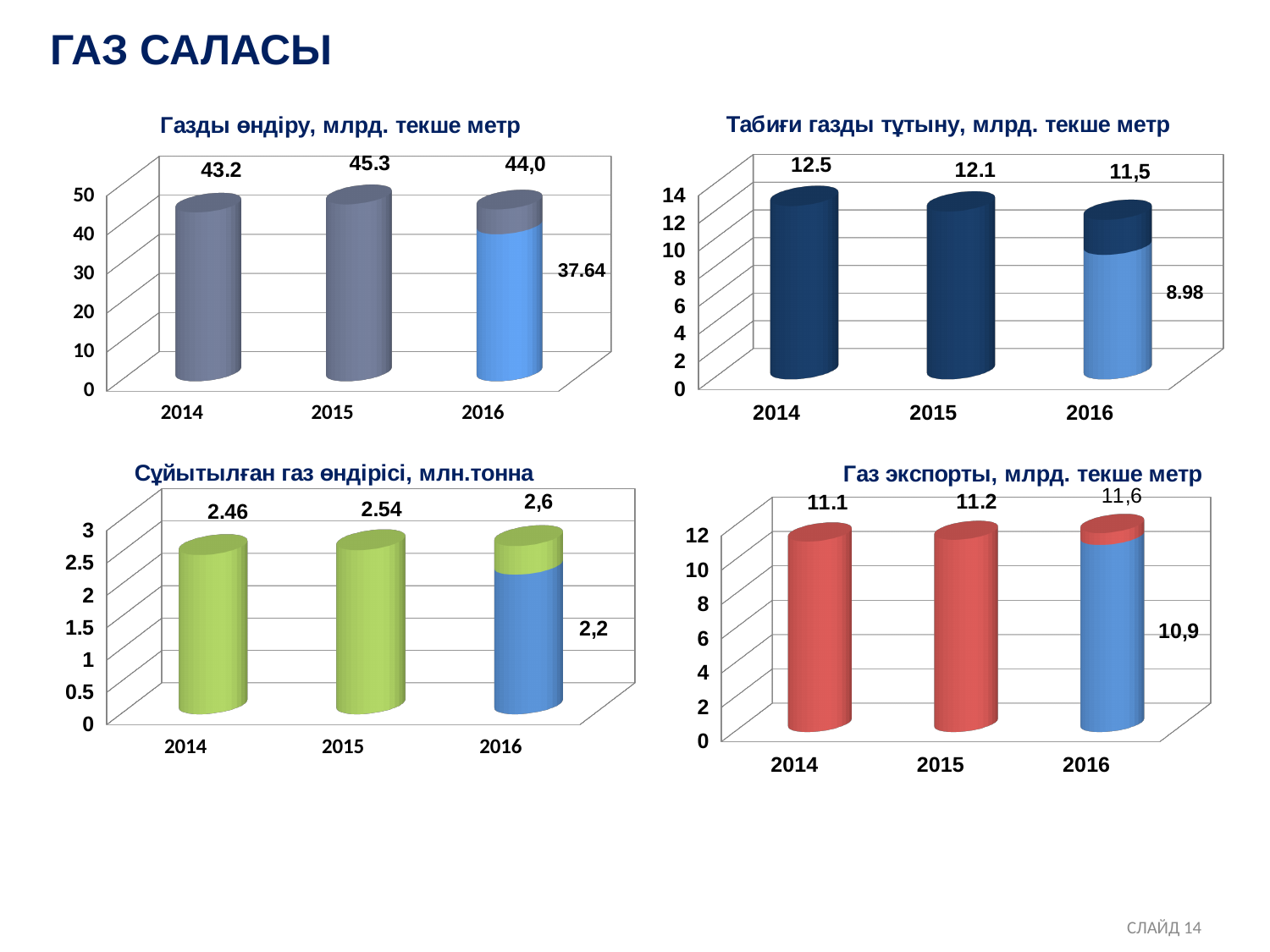
In the chart titled "Газды өндіру, млрд. текше метр", what is the difference between the 2015 value and the 2014 value? 2.1 In the chart titled "Газ экспорты, млрд. текше метр", what is the difference between the 2015 value and the 2014 value? 0.1 In the chart titled "Табиғи газды тұтыну, млрд. текше метр", which year has the lowest value? 2016 What kind of chart is the chart titled "Сұйытылған газ өндірісі, млн.тонна"? bar chart In the chart titled "Сұйытылған газ өндірісі, млн.тонна", what is the value for 2014? 2.46 In the chart titled "Табиғи газды тұтыну, млрд. текше метр", do the values rise or fall from 2014 to 2016? fall In the chart titled "Газды өндіру, млрд. текше метр", which year has the highest value? 2015 In the chart titled "Сұйытылған газ өндірісі, млн.тонна", which is larger, the value for 2014 or the value for 2015? 2015 How many years are shown on the x axis of the chart titled "Газ экспорты, млрд. текше метр"? 3 In the chart titled "Табиғи газды тұтыну, млрд. текше метр", what is the value for 2014? 12.5 In the chart titled "Газ экспорты, млрд. текше метр", what is the value for 2016? 11,6 In the chart titled "Газды өндіру, млрд. текше метр", what is the value for 2015? 45.3